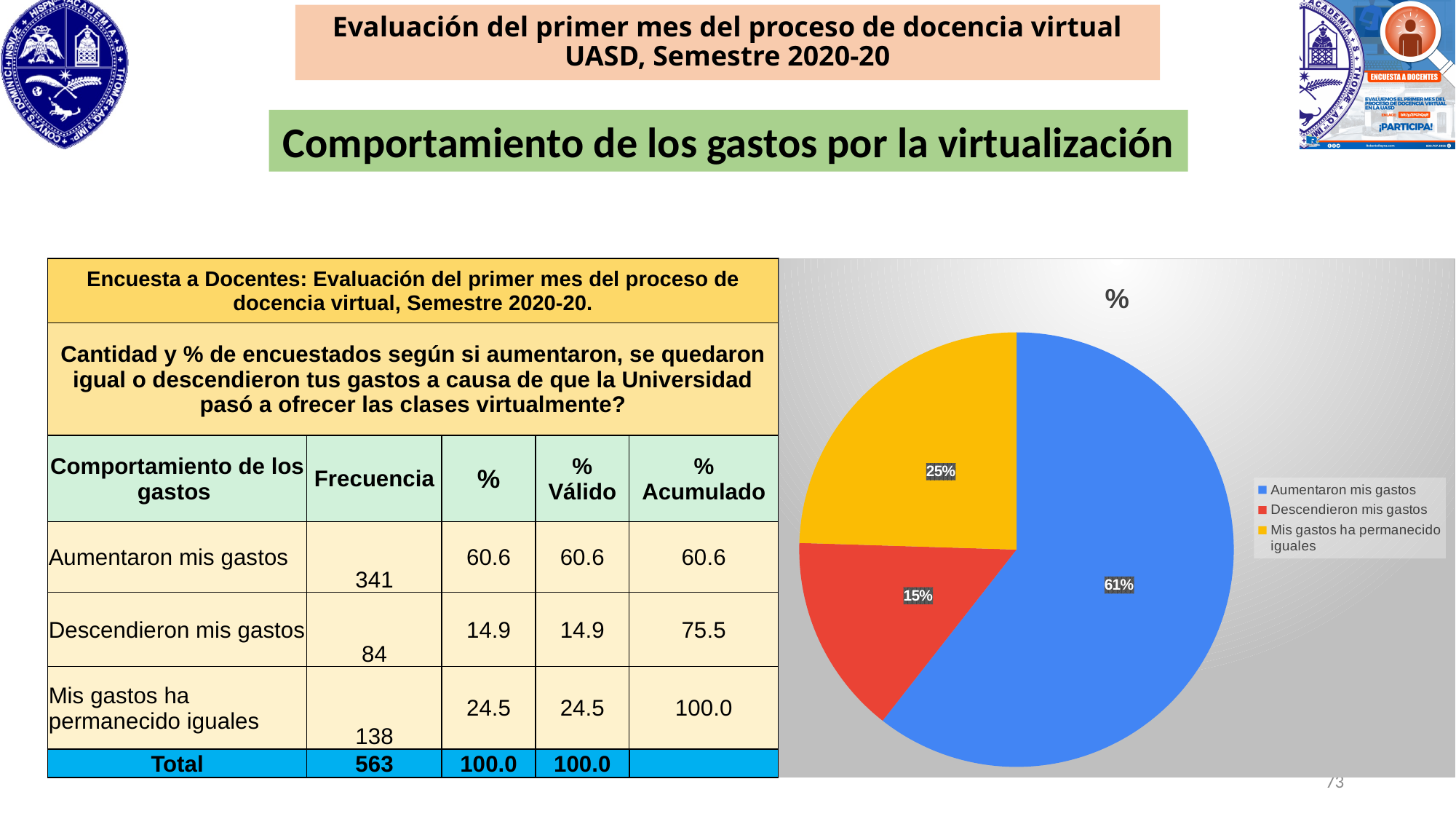
What colour is the 'Descendieron mis gastos' slice in the pie chart? red What percentage is shown for the 'Aumentaron mis gastos' slice in the pie chart? 61% What percentage is shown for the 'Mis gastos ha permanecido iguales' slice in the pie chart? 25% What is the title of the pie chart? % What is the difference in percentage points between the 'Aumentaron mis gastos' slice and the 'Mis gastos ha permanecido iguales' slice in the pie chart? 36% Which category has the smallest slice in the pie chart? Descendieron mis gastos Which category has the largest slice in the pie chart? Aumentaron mis gastos Which slice is larger in the pie chart: 'Mis gastos ha permanecido iguales' or 'Descendieron mis gastos'? Mis gastos ha permanecido iguales What percentage is shown for the 'Descendieron mis gastos' slice in the pie chart? 15% How many slices does the pie chart have? 3 How many entries does the pie chart's legend list? 3 What kind of chart is shown on the slide? pie chart